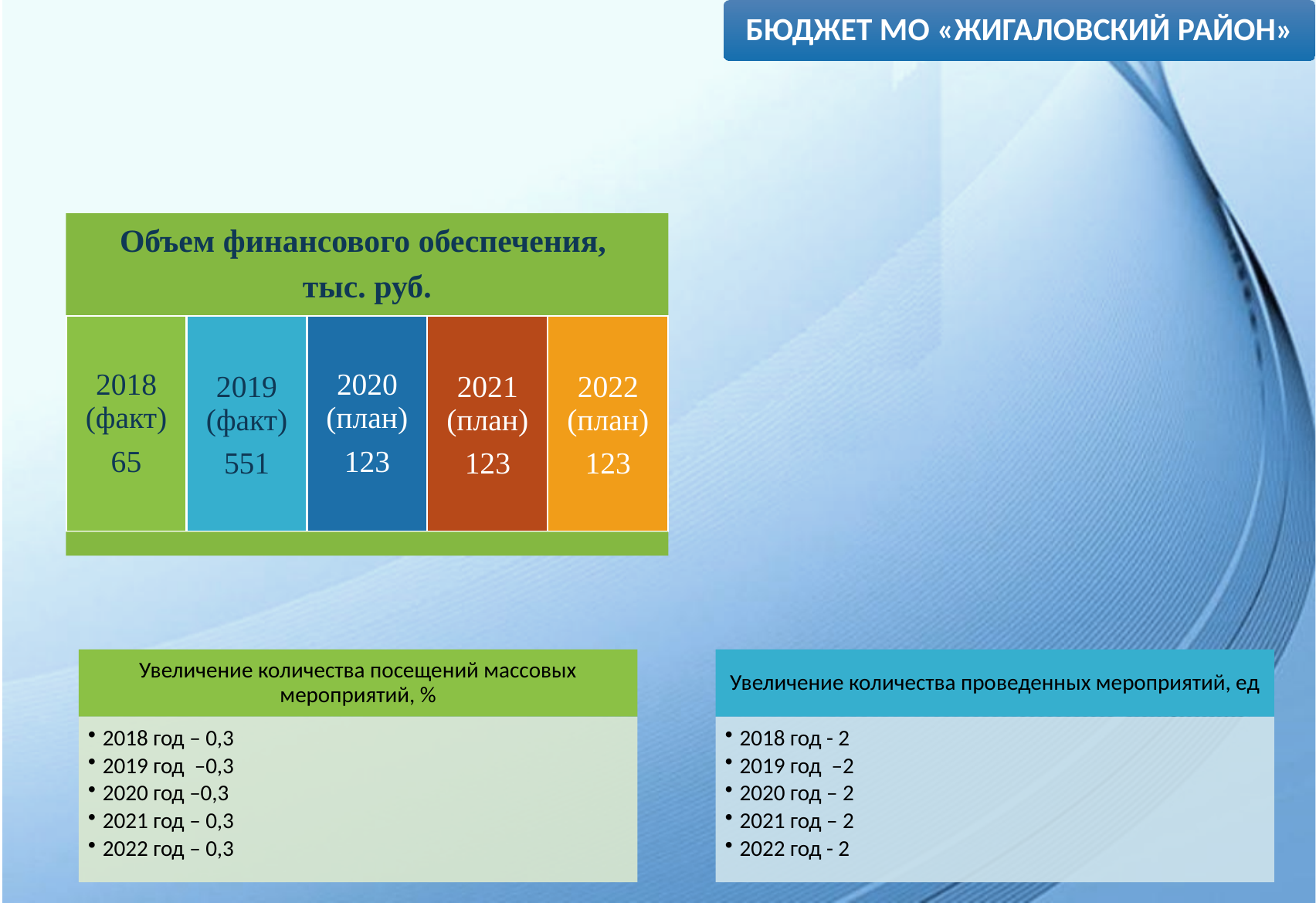
In the 'Объем финансового обеспечения, тыс. руб.' graphic, what colour is the block for 2021 (план)? Dark orange (brown-red) In the 'Объем финансового обеспечения, тыс. руб.' graphic, what is the difference between the 2019 (факт) and 2020 (план) values? 428 In the 'Объем финансового обеспечения, тыс. руб.' graphic, which is larger: the value for 2018 (факт) or 2020 (план)? 2020 (план) In the 'Объем финансового обеспечения, тыс. руб.' graphic, which year has the lowest value? 2018 (факт) In the 'Объем финансового обеспечения, тыс. руб.' graphic, what is the value for 2018 (факт)? 65 How many years are shown in the 'Объем финансового обеспечения, тыс. руб.' graphic? 5 What is the title of the graphic showing values for 2018 to 2022? Объем финансового обеспечения, тыс. руб. In the 'Объем финансового обеспечения, тыс. руб.' graphic, what is the value for 2020 (план)? 123 In the 'Объем финансового обеспечения, тыс. руб.' graphic, which year has the highest value? 2019 (факт) In the 'Объем финансового обеспечения, тыс. руб.' graphic, what is the difference between the 2019 (факт) and 2018 (факт) values? 486 In the 'Объем финансового обеспечения, тыс. руб.' graphic, what is the value for 2022 (план)? 123 In the 'Объем финансового обеспечения, тыс. руб.' graphic, what is the value for 2019 (факт)? 551